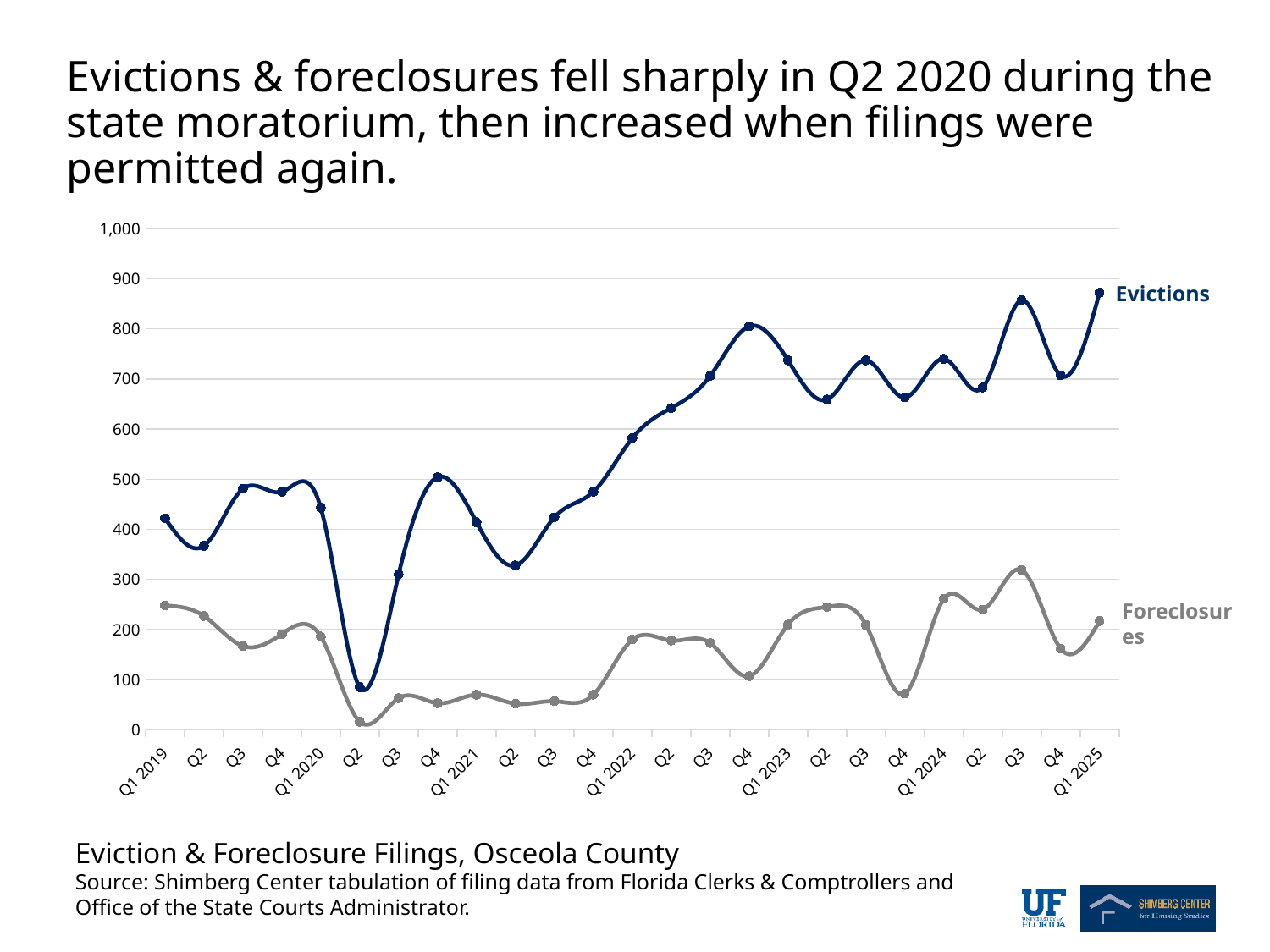
How many series are plotted on the chart? 2 Is the value for Evictions in Q1 2025 greater or less than 800? greater Is the value for Evictions in Q2 2020 greater or less than 100? less Is the value for Foreclosures in Q3 2024 greater or less than 300? greater Do Evictions rise or fall from Q1 2022 to Q4 2022? Rise In which quarter is the Foreclosures line at its lowest? Q2 2020 How many quarterly data points does each line have, from Q1 2019 to Q1 2025? 25 In which quarter is the Foreclosures line at its highest? Q3 2024 In which quarter is the Evictions line at its lowest? Q2 2020 What is the title of the chart shown below the plot? Eviction & Foreclosure Filings, Osceola County Which series has the higher value in Q1 2022, Evictions or Foreclosures? Evictions What kind of chart is shown on the slide? Line chart